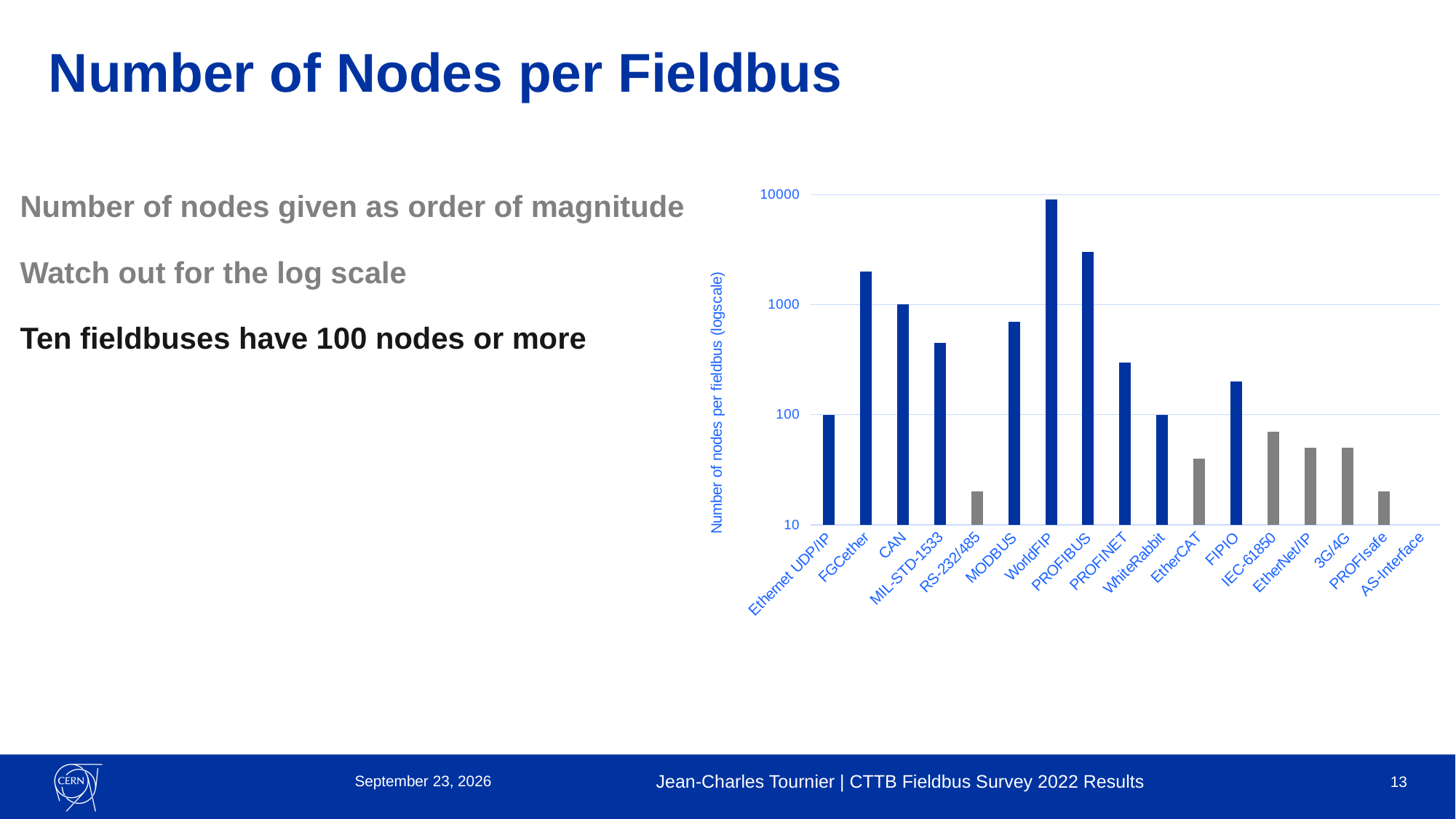
Is the value for MODBUS greater or less than 1000? less Is the value for FGCether greater or less than 1000? greater Which has more nodes, WorldFIP or PROFIBUS? WorldFIP What is the number of nodes for CAN? 1000 Which has more nodes, MODBUS or MIL-STD-1533? MODBUS How many fieldbuses are listed on the x axis of the chart? 17 Is the value for FIPIO greater or less than 100? greater What kind of chart is shown on the slide? Bar chart What is the label of the y axis of the chart? Number of nodes per fieldbus (logscale) What is the number of nodes for Ethernet UDP/IP? 100 Which fieldbus has the highest number of nodes in the chart? WorldFIP